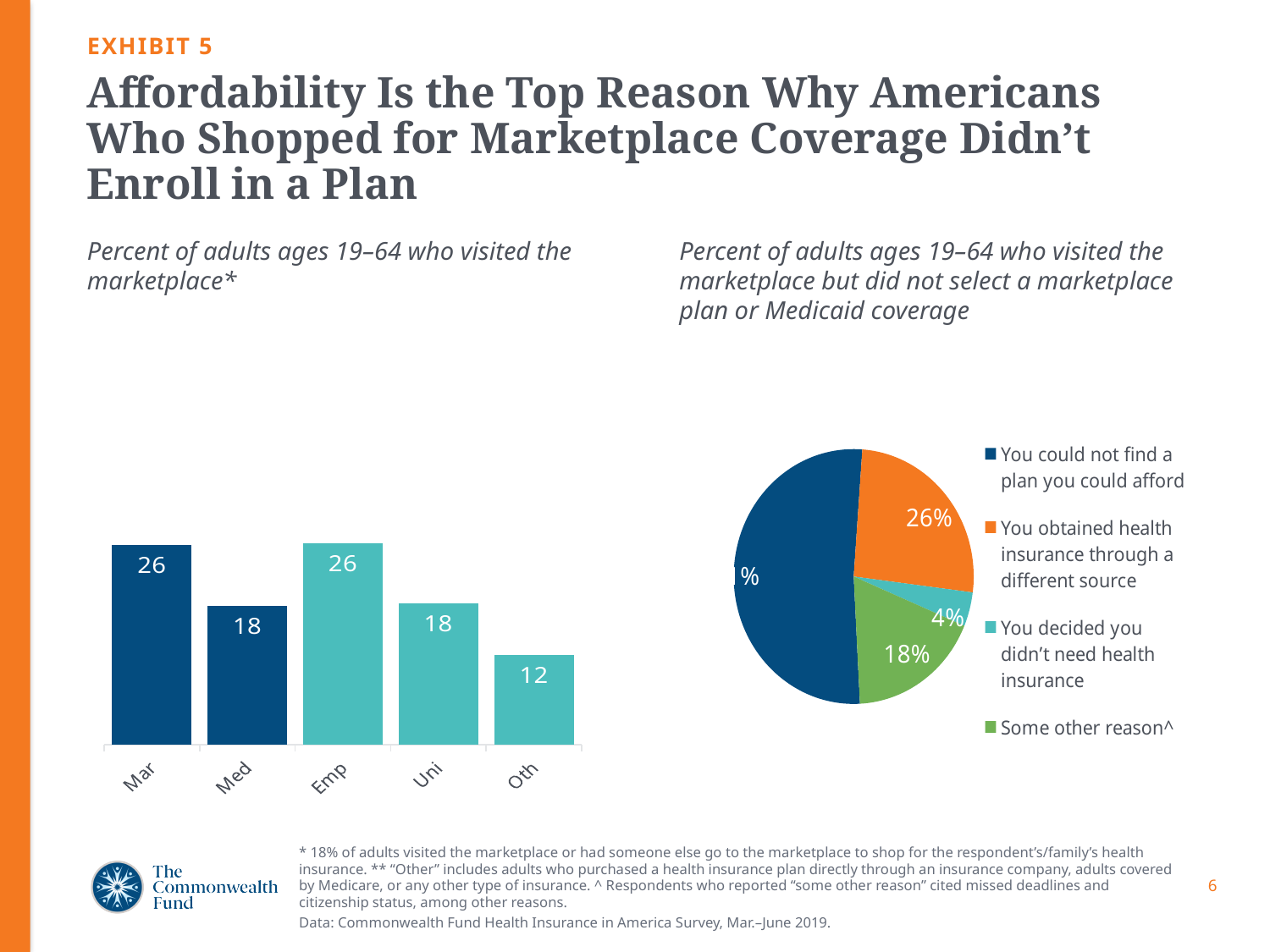
On the left bar chart, what is the difference between the values for Emp and Uni? 8 On the right pie chart, what share is labelled for 'You decided you didn't need health insurance'? 4% On the right pie chart, what is the difference between the 'Some other reason' slice and the 'You decided you didn't need health insurance' slice? 14% What kind of chart is on the left side of the slide? Bar chart How many entries does the legend of the right pie chart list? 4 On the right pie chart, which reason has the largest slice? You could not find a plan you could afford On the left bar chart, which category has the lowest value? Oth On the left bar chart, what is the value for Mar? 26 On the right pie chart, what share is labelled for 'You obtained health insurance through a different source'? 26% On the left bar chart, which is larger, the value for Mar or the value for Med? Mar How many categories are shown on the left bar chart? 5 On the left bar chart, what is the value for Oth? 12